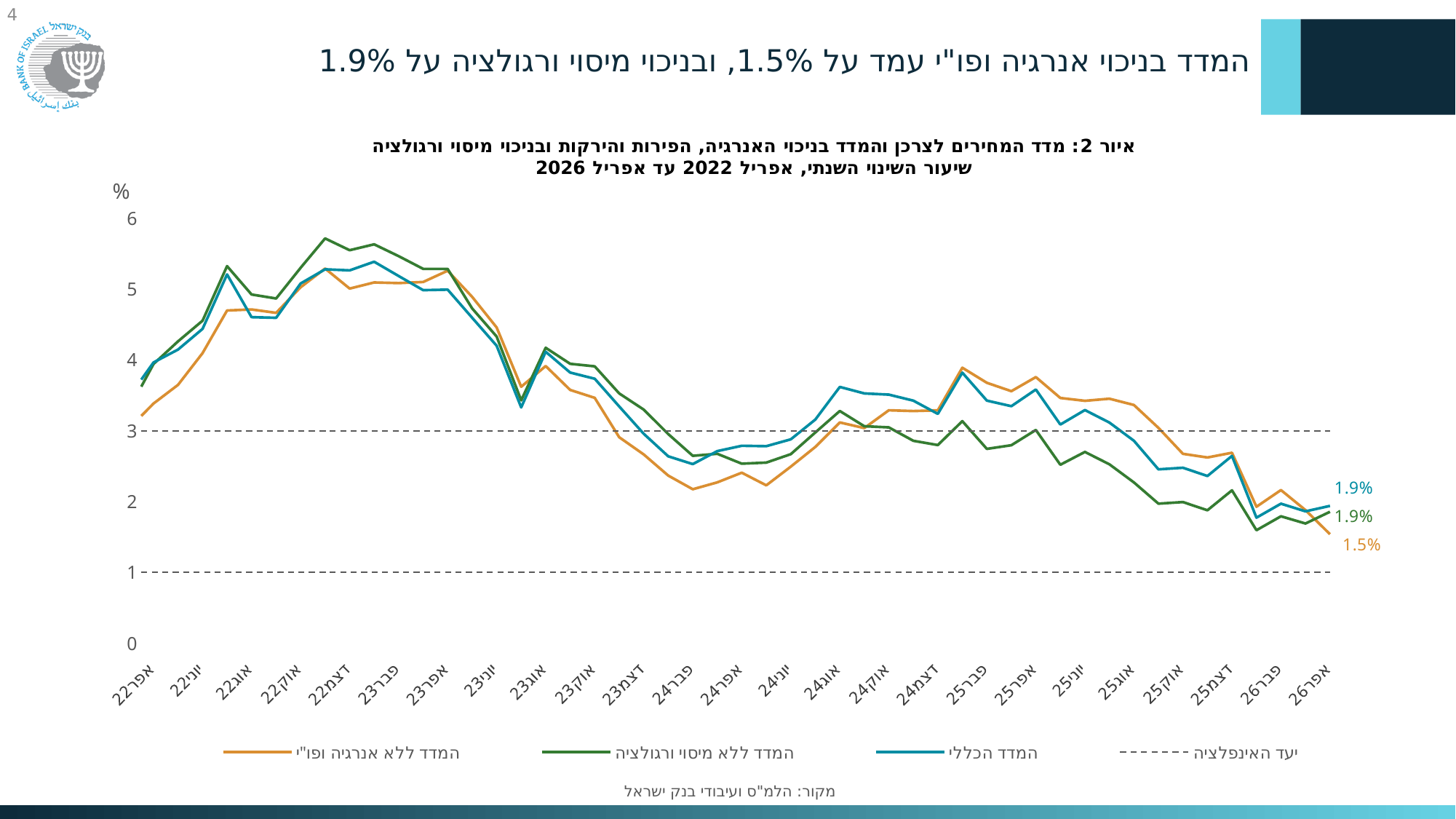
What is the value of המדד הכללי at אפר26, as labelled at the end of the line? 1.9% At אפר26, which is higher: המדד הכללי or המדד ללא אנרגיה ופו"י? המדד הכללי What type of chart is shown on the slide? line chart What is the difference between המדד הכללי and המדד ללא אנרגיה ופו"י at אפר26, in percentage points? 0.4 What is the value of המדד ללא מיסוי ורגולציה at אפר26, as labelled at the end of the line? 1.9% Is the value of המדד הכללי at דצמ22 greater or less than 5? greater Is the value of המדד ללא אנרגיה ופו"י at פבר24 greater or less than 3? less Which series has the lowest value at אפר26? המדד ללא אנרגיה ופו"י What is the value of המדד ללא אנרגיה ופו"י at אפר26, as labelled at the end of the line? 1.5% At what values on the y axis are the two dashed יעד האינפלציה lines drawn? 1 and 3 Between אפר22 and דצמ22, does המדד הכללי rise or fall? rise How many entries does the chart legend list? 4